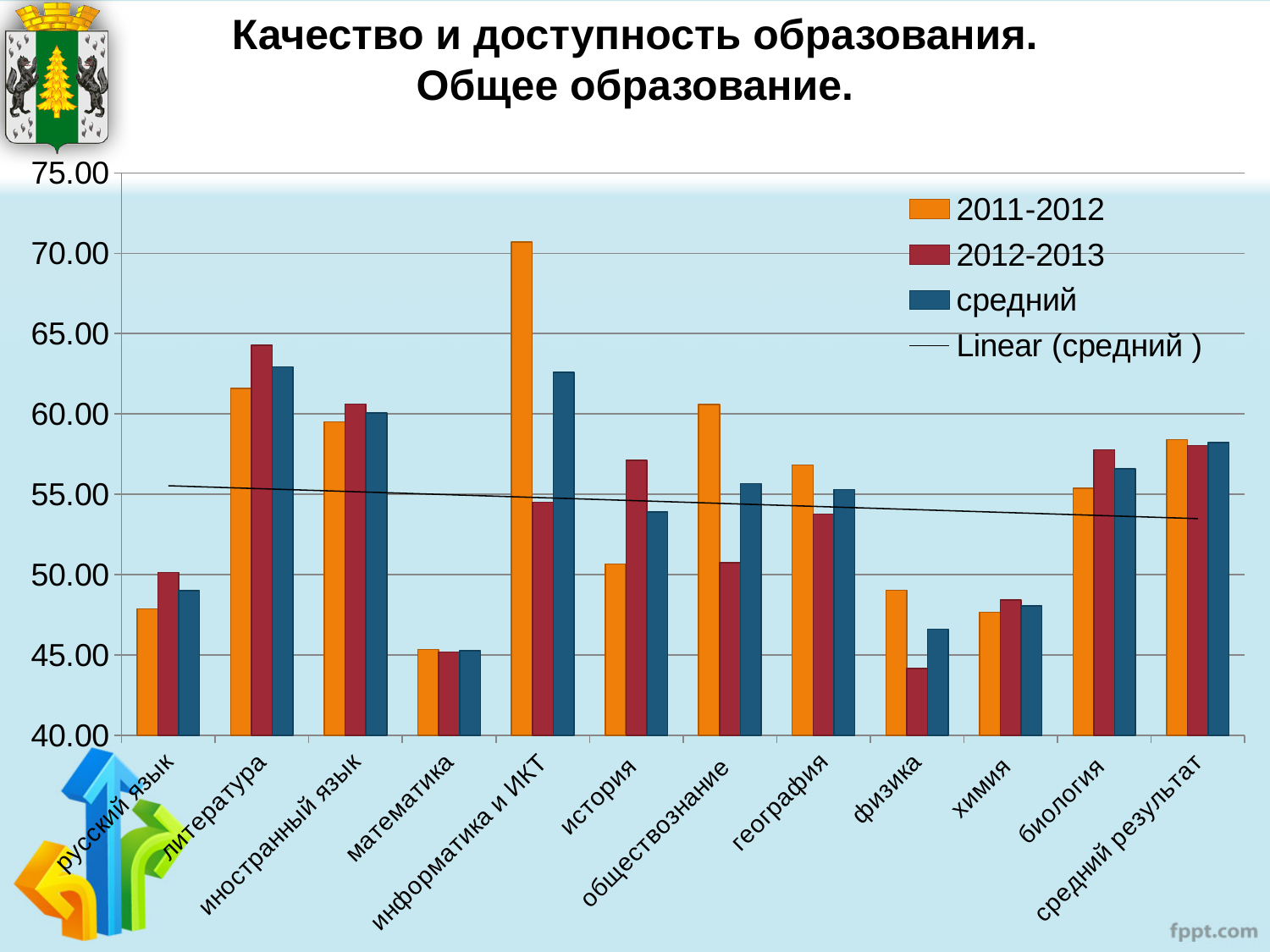
How many subject categories are shown along the x axis? 12 Is the 2011-2012 value for информатика и ИКТ greater or less than 65? greater What kind of chart is shown on the slide? bar chart Which category has the highest value for the 2011-2012 series? информатика и ИКТ Which category has the lowest value for the 2012-2013 series? физика How many entries does the legend list? 4 Is the 2011-2012 value for русский язык greater or less than 50? less Does the Linear (средний) trend line rise or fall from left to right? fall Which category has the highest value for the 2012-2013 series? литература Which category has the lowest value for the 2011-2012 series? математика For история, which series has the larger value: 2011-2012 or 2012-2013? 2012-2013 Is the 2012-2013 value for физика greater or less than 45? less